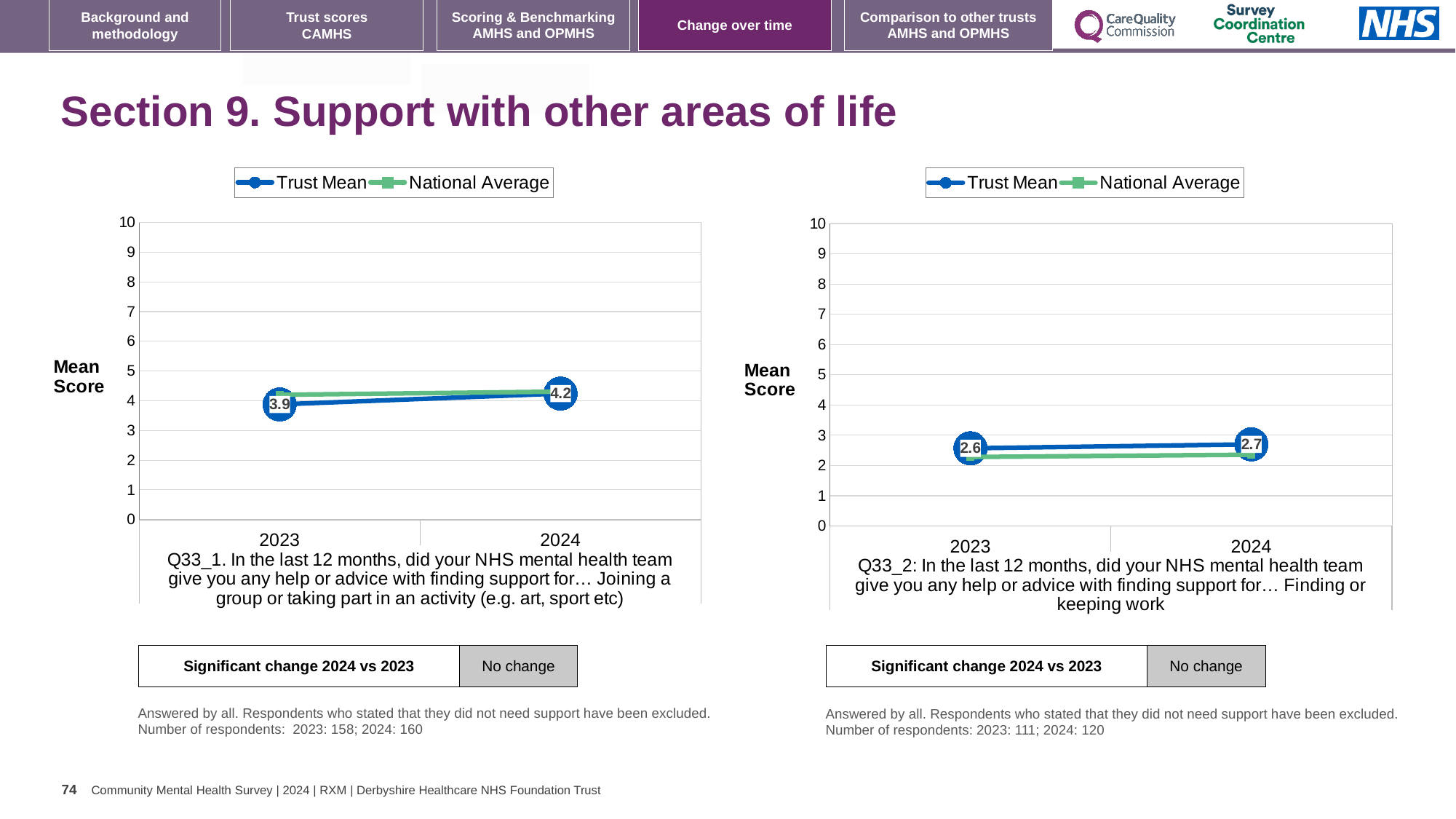
How many years are plotted on the x axis of the left chart (Q33_1)? 2 In the left chart (Q33_1), what is the Trust Mean score for 2024? 4.2 In the right chart (Q33_2), what is the Trust Mean score for 2024? 2.7 How many series does the legend of the right chart (Q33_2) list? 2 In the left chart (Q33_1), by how much did the Trust Mean change from 2023 to 2024? 0.3 In the right chart (Q33_2), what is the Trust Mean score for 2023? 2.6 What type of chart is used on this slide? line chart In the right chart (Q33_2), what is the difference between the Trust Mean for 2024 and 2023? 0.1 In the right chart (Q33_2), is the National Average for 2024 greater or less than 3? less In the left chart (Q33_1), does the Trust Mean rise or fall from 2023 to 2024? rise In the left chart (Q33_1), what is the Trust Mean score for 2023? 3.9 In the right chart (Q33_2), which is higher in 2023: the Trust Mean or the National Average? Trust Mean